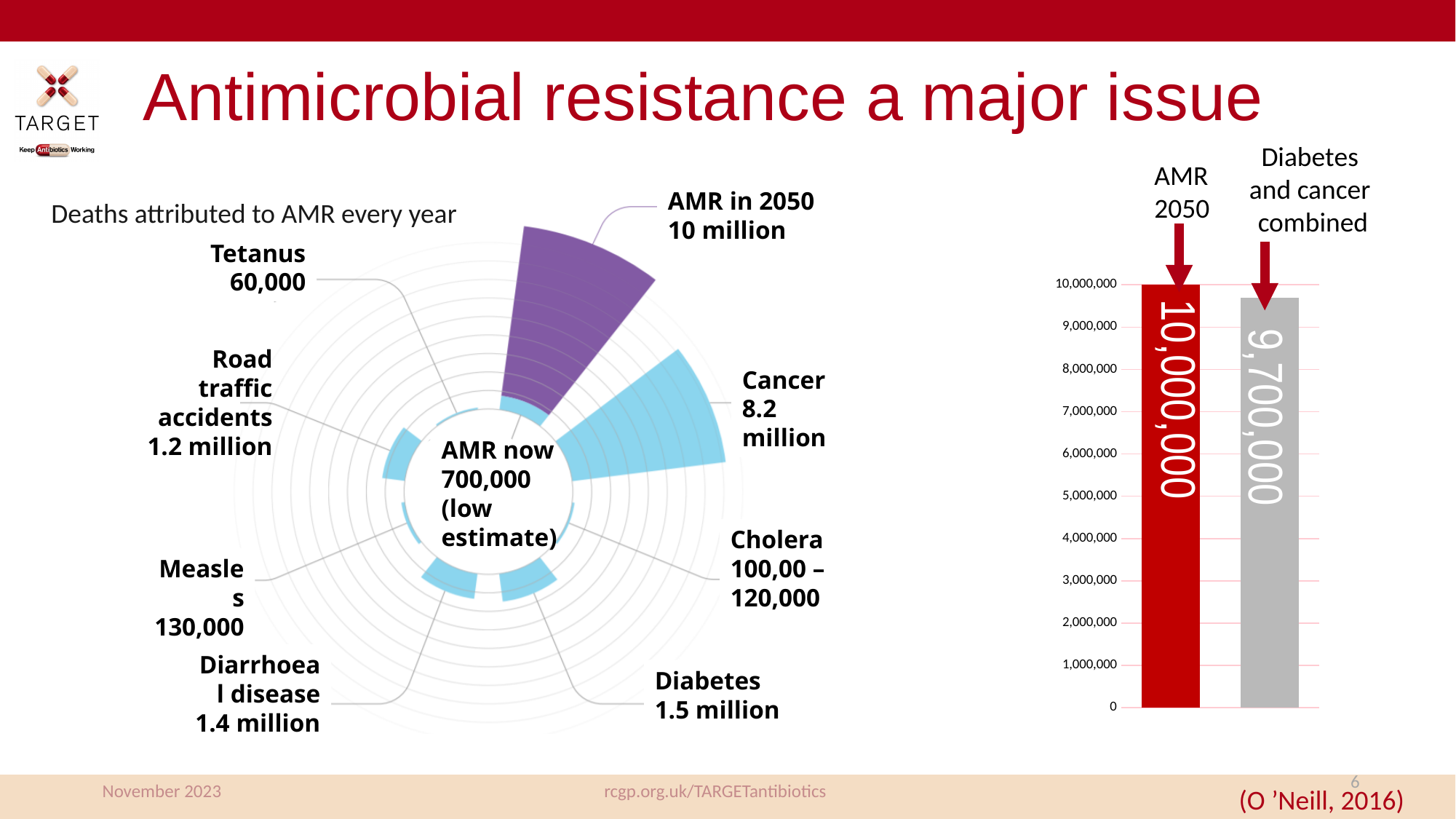
In the bar chart on the right, what is the value for Diabetes and cancer combined? 9,700,000 In the 'Deaths attributed to AMR every year' chart on the left, which category has the highest value? AMR in 2050 In the 'Deaths attributed to AMR every year' chart on the left, what is the value for Cancer? 8.2 million What kind of chart is shown on the right side of the slide? Bar chart In the 'Deaths attributed to AMR every year' chart on the left, what is the value for Tetanus? 60,000 In the bar chart on the right, which bar is larger: AMR 2050 or Diabetes and cancer combined? AMR 2050 In the bar chart on the right, what is the value for AMR 2050? 10,000,000 How many bars are in the bar chart on the right? 2 In the 'Deaths attributed to AMR every year' chart on the left, which category has the lowest value? Tetanus In the 'Deaths attributed to AMR every year' chart on the left, which is larger: Diabetes or Road traffic accidents? Diabetes In the 'Deaths attributed to AMR every year' chart on the left, what is the value for AMR in 2050? 10 million In the bar chart on the right, what is the difference between the AMR 2050 bar and the Diabetes and cancer combined bar? 300,000